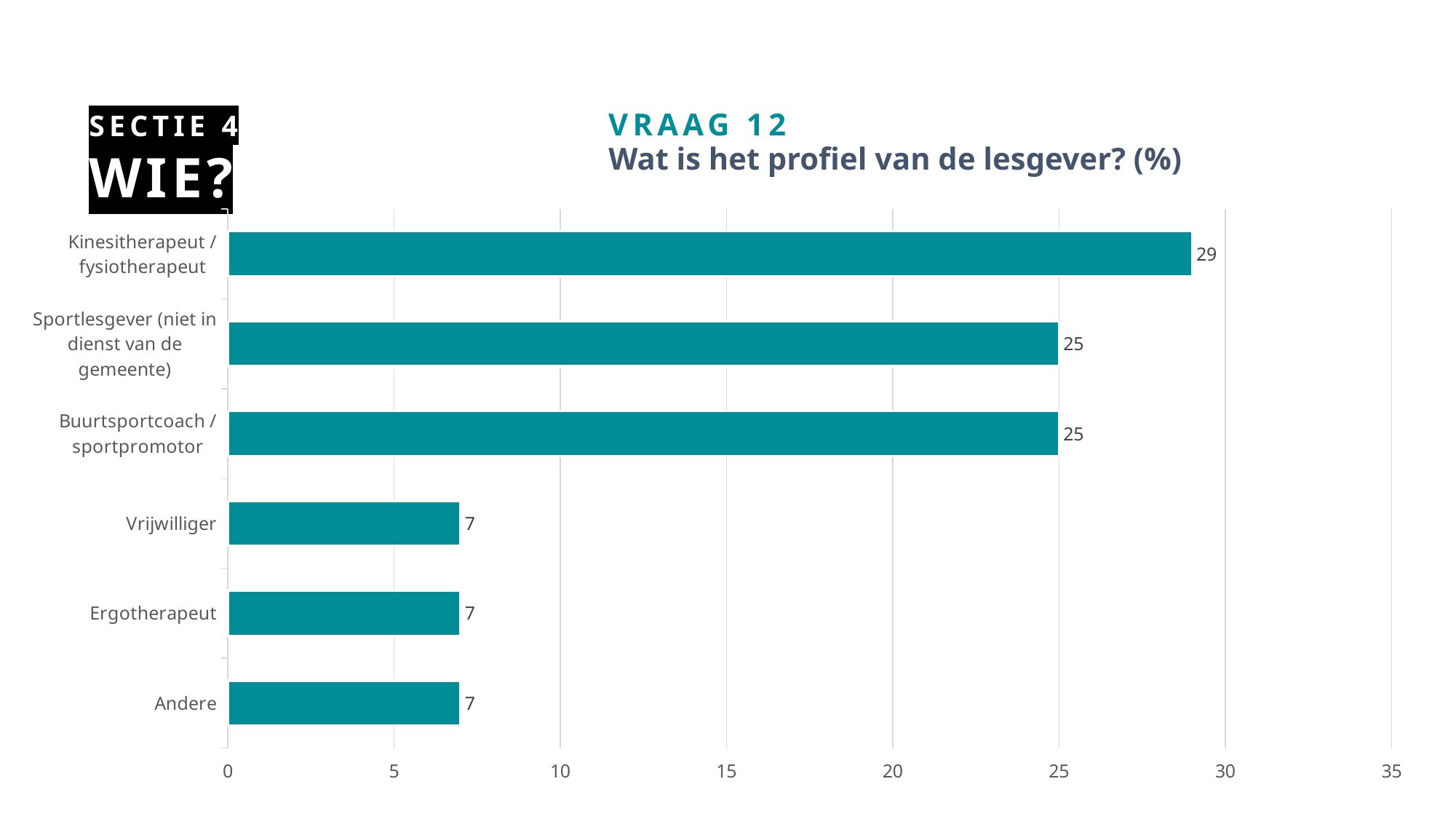
What is the value for Kinesitherapeut / fysiotherapeut? 29 Which is larger, the value for Buurtsportcoach / sportpromotor or the value for Vrijwilliger? Buurtsportcoach / sportpromotor What is the title of the chart? Wat is het profiel van de lesgever? (%) What is the value for Sportlesgever (niet in dienst van de gemeente)? 25 How many categories are shown in the chart? 6 Is the value for Kinesitherapeut / fysiotherapeut greater or less than 30? less What is the difference between the values for Kinesitherapeut / fysiotherapeut and Buurtsportcoach / sportpromotor? 4 What is the value for Andere? 7 What kind of chart is shown on the slide? bar chart What is the difference between the values for Sportlesgever (niet in dienst van de gemeente) and Ergotherapeut? 18 Which category has the highest value? Kinesitherapeut / fysiotherapeut What is the value for Vrijwilliger? 7